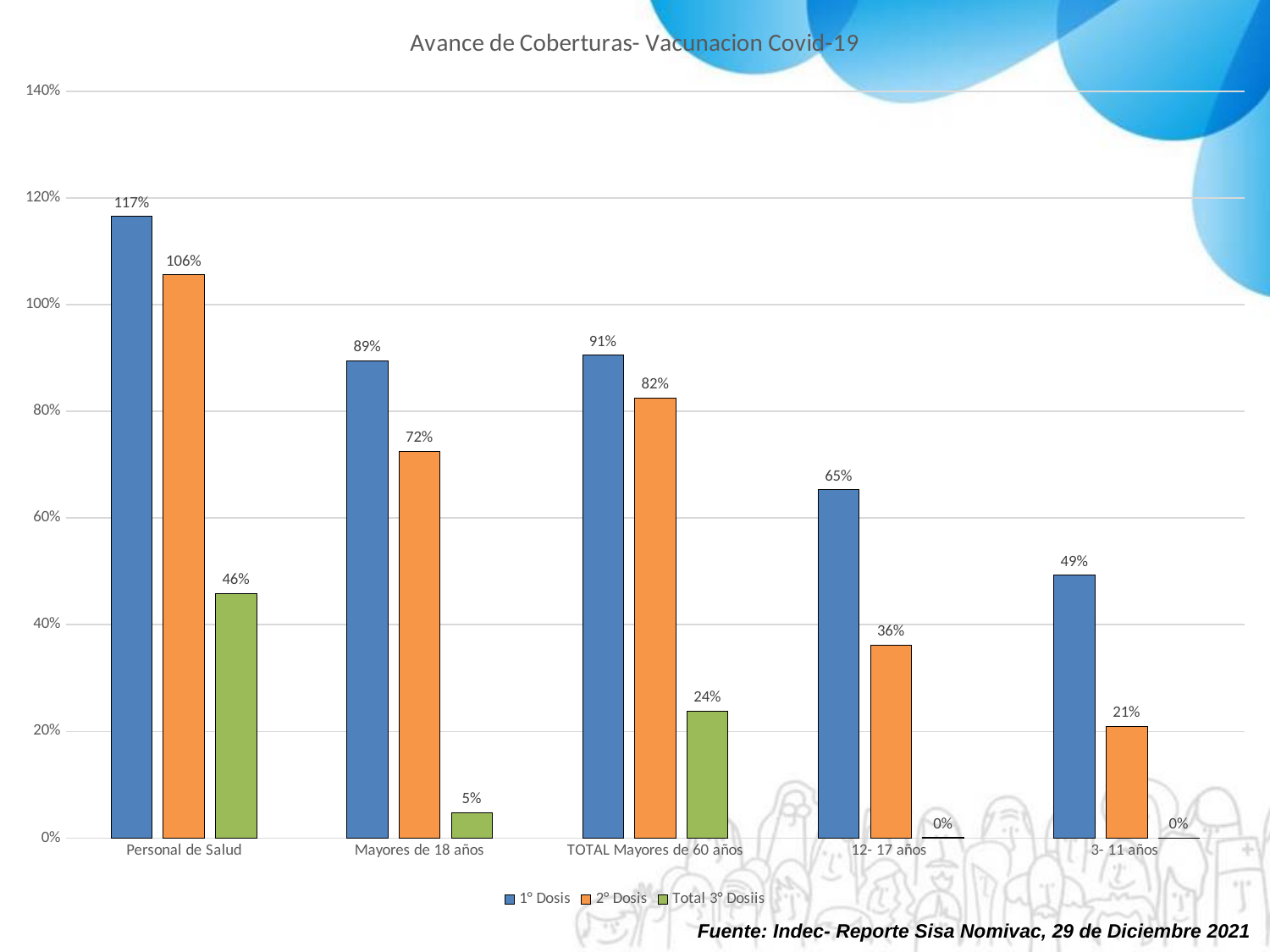
What is the title of the chart? Avance de Coberturas- Vacunacion Covid-19 How many series does the legend list? 3 How many categories are shown on the x axis? 5 What is the 2° Dosis value for Mayores de 18 años? 72% What is the difference between the 1° Dosis and 2° Dosis values for 12- 17 años? 29% What is the 1° Dosis value for Personal de Salud? 117% Which category has the highest 1° Dosis value? Personal de Salud What is the Total 3° Dosiis value for 3- 11 años? 0% Which category has the lowest 2° Dosis value? 3- 11 años What kind of chart is shown on the slide? Bar chart What is the Total 3° Dosiis value for TOTAL Mayores de 60 años? 24% Which is larger: the 2° Dosis value for TOTAL Mayores de 60 años or the 1° Dosis value for 12- 17 años? 2° Dosis for TOTAL Mayores de 60 años